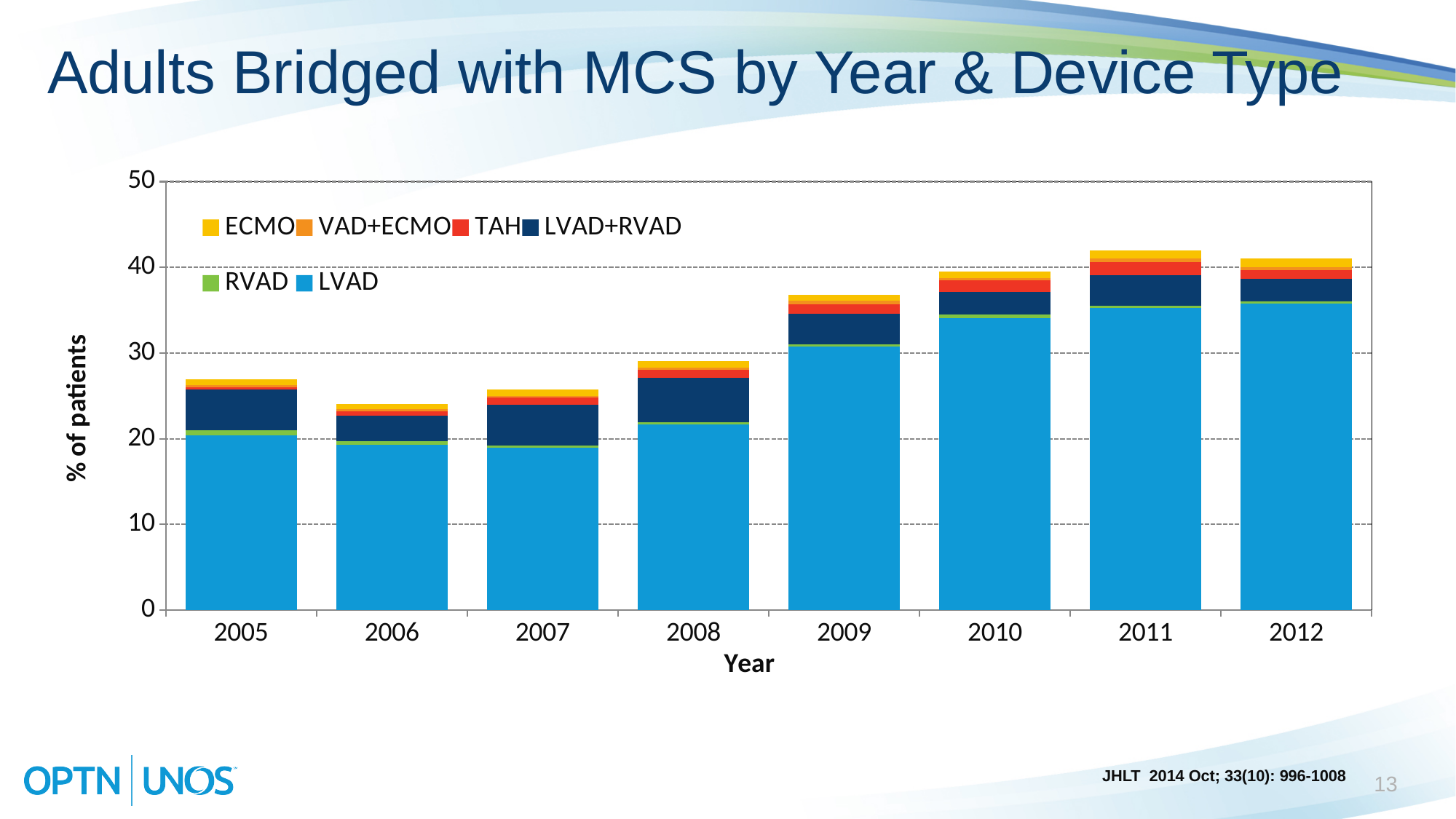
Is the LVAD value for 2012 greater or less than 30? greater What is the label on the y axis? % of patients Which year has the tallest stacked bar overall? 2011 Is the total bar height for 2011 greater or less than 40? greater Which year has a taller total bar, 2008 or 2009? 2009 Which year has the shortest stacked bar overall? 2006 How many years are shown on the x axis? 8 What kind of chart is shown on the slide? Stacked bar chart Is the total bar height for 2005 greater or less than 30? less How many series does the legend list? 6 Do the total bar heights rise or fall from 2008 to 2011? Rise